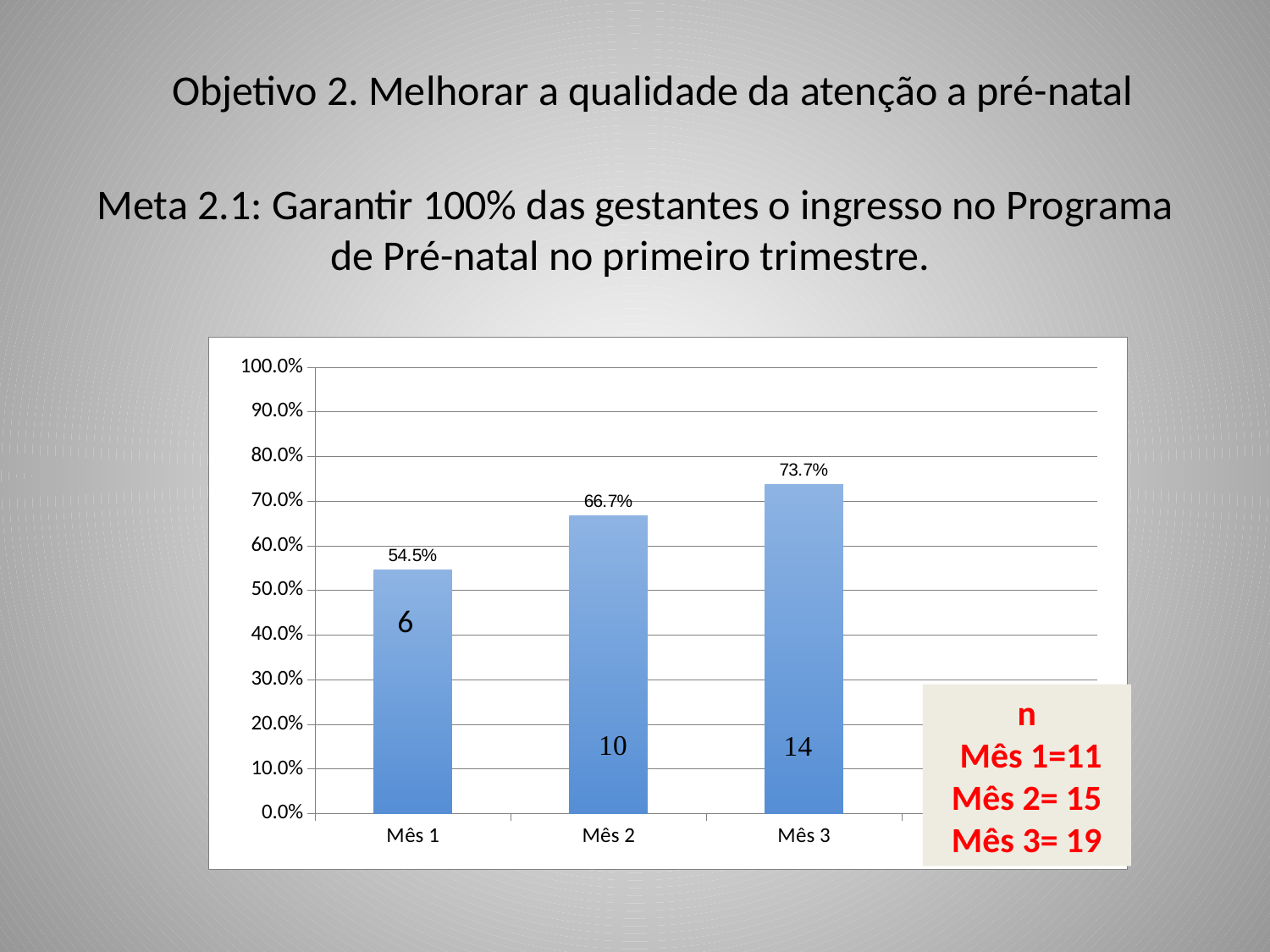
Do the values rise or fall from Mês 1 to Mês 3? rise What kind of chart is shown on the slide? bar chart Which month has the lowest value? Mês 1 Is the value for Mês 3 greater or less than 70.0%? greater How many months are shown on the x axis? 3 Which month has the highest value? Mês 3 What is the difference between the values for Mês 3 and Mês 1? 19.2% Which is larger, the value for Mês 2 or the value for Mês 1? Mês 2 What is the value for Mês 2? 66.7% What is the value for Mês 1? 54.5% What number is printed inside the bar for Mês 2? 10 What is the value for Mês 3? 73.7%